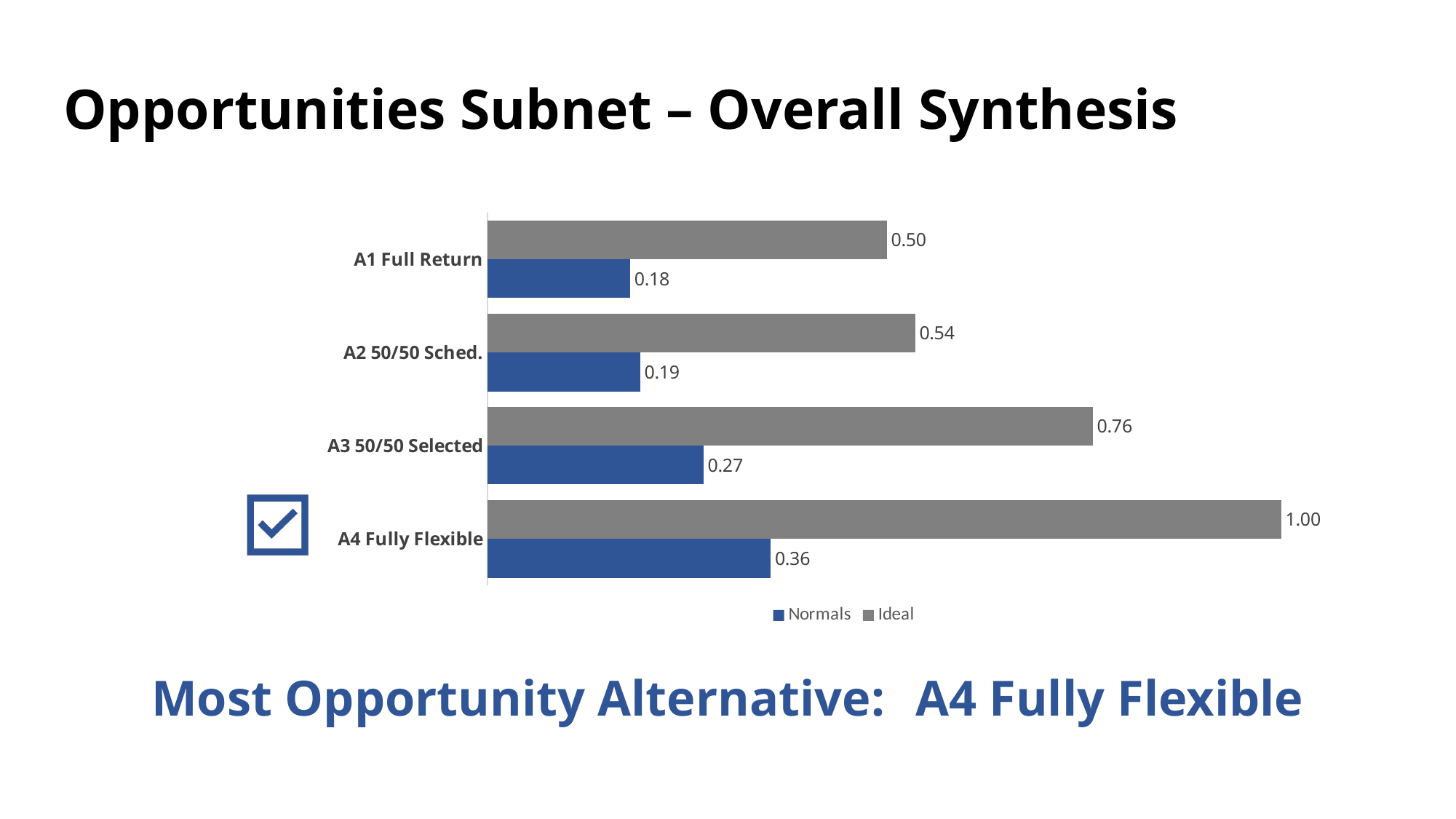
What kind of chart is shown on the slide? Bar chart What is the Ideal value for A3 50/50 Selected? 0.76 What is the difference between the Ideal and Normals values for A2 50/50 Sched.? 0.35 Which colour represents the Ideal series? Grey Which is larger, the Normals value for A3 50/50 Selected or the Normals value for A2 50/50 Sched.? A3 50/50 Selected What is the difference between the Ideal values for A4 Fully Flexible and A1 Full Return? 0.50 How many series does the legend list? 2 What is the Normals value for A1 Full Return? 0.18 What is the Normals value for A4 Fully Flexible? 0.36 Which category has the lowest Normals value? A1 Full Return Which category has the highest Ideal value? A4 Fully Flexible How many categories are shown on the chart? 4